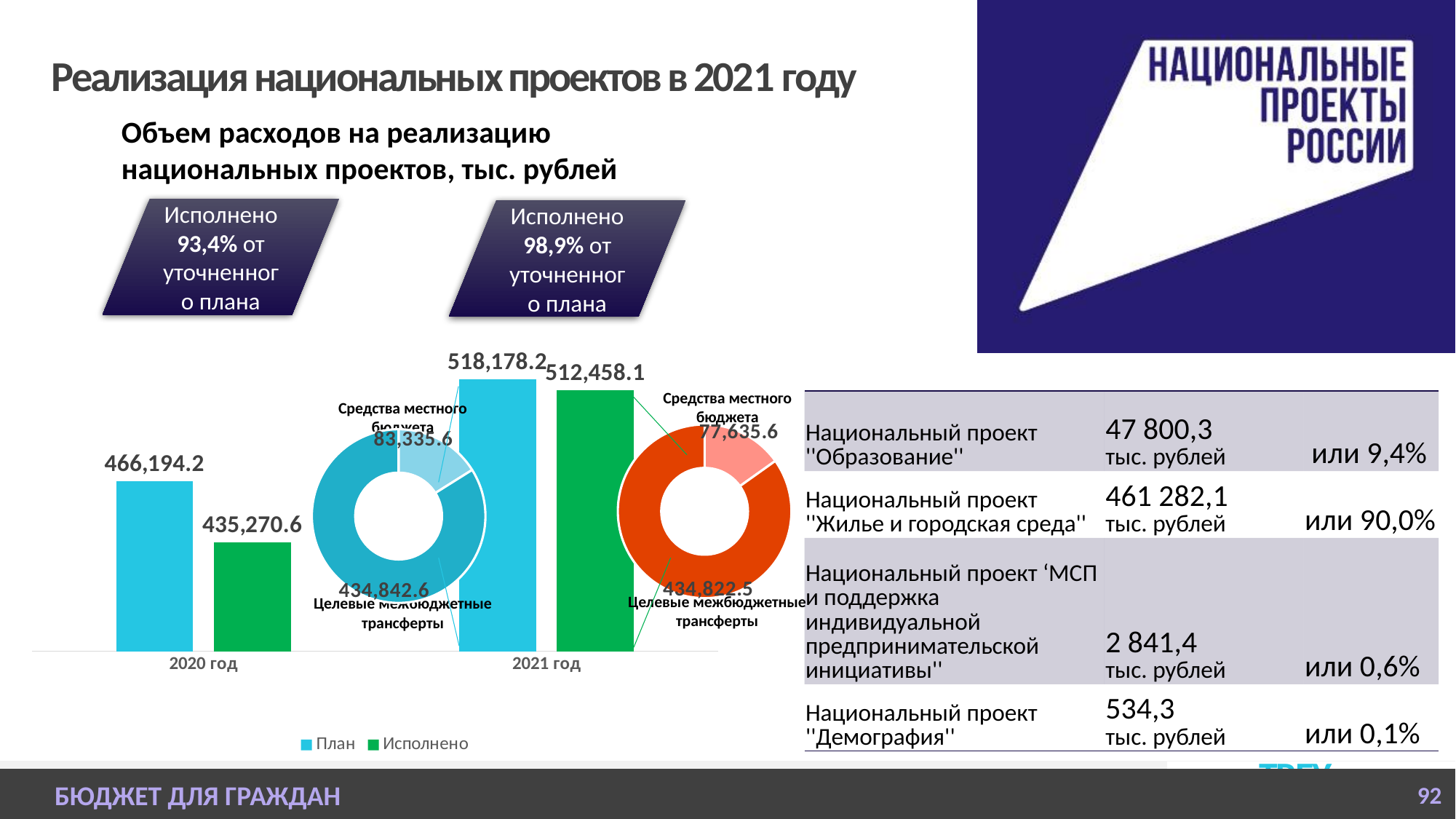
On the bar chart, what is the value of План for 2020 год? 466,194.2 On the right (orange) donut chart, which slice is larger: Средства местного бюджета or Целевые межбюджетные трансферты? Целевые межбюджетные трансферты On the bar chart, what is the difference between План and Исполнено for 2021 год? 5,720.1 On the right (orange) donut chart, what is the value for Целевые межбюджетные трансферты? 434,822.5 On the bar chart, does the Исполнено value rise or fall from 2020 год to 2021 год? rise On the bar chart, which bar is the lowest? Исполнено, 2020 год On the bar chart, how many series does the legend list? 2 On the bar chart, what is the value of Исполнено for 2021 год? 512,458.1 On the bar chart, which bar is the highest? План, 2021 год On the bar chart, what is the value of Исполнено for 2020 год? 435,270.6 On the left (blue) donut chart, what is the value for Средства местного бюджета? 83,335.6 On the bar chart, what is the difference between План and Исполнено for 2020 год? 30,923.6